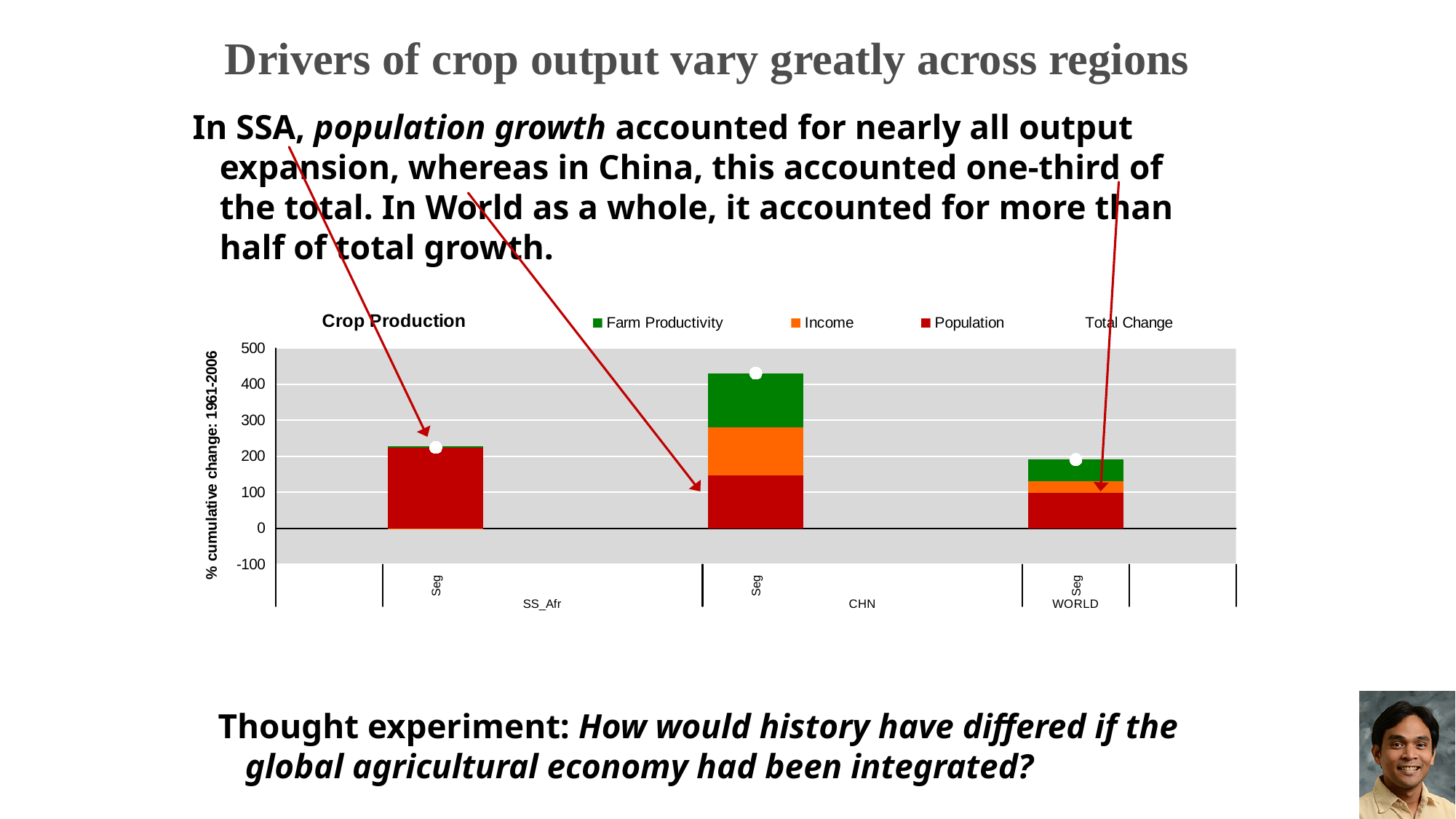
Which colour represents Farm Productivity in the chart? green How many regions are plotted on the x axis of the chart? 3 How many entries does the chart legend list? 4 Is the total change for CHN greater or less than 400? greater Which region has the highest total cumulative change in crop production? CHN Which region has the lowest total cumulative change in crop production? WORLD Is the Population contribution for SS_Afr greater or less than 200? greater What kind of chart is shown on the slide? stacked bar chart What is the title of the chart? Crop Production Which is larger, the total change for SS_Afr or for WORLD? SS_Afr Is the Population contribution for CHN greater or less than 100? greater